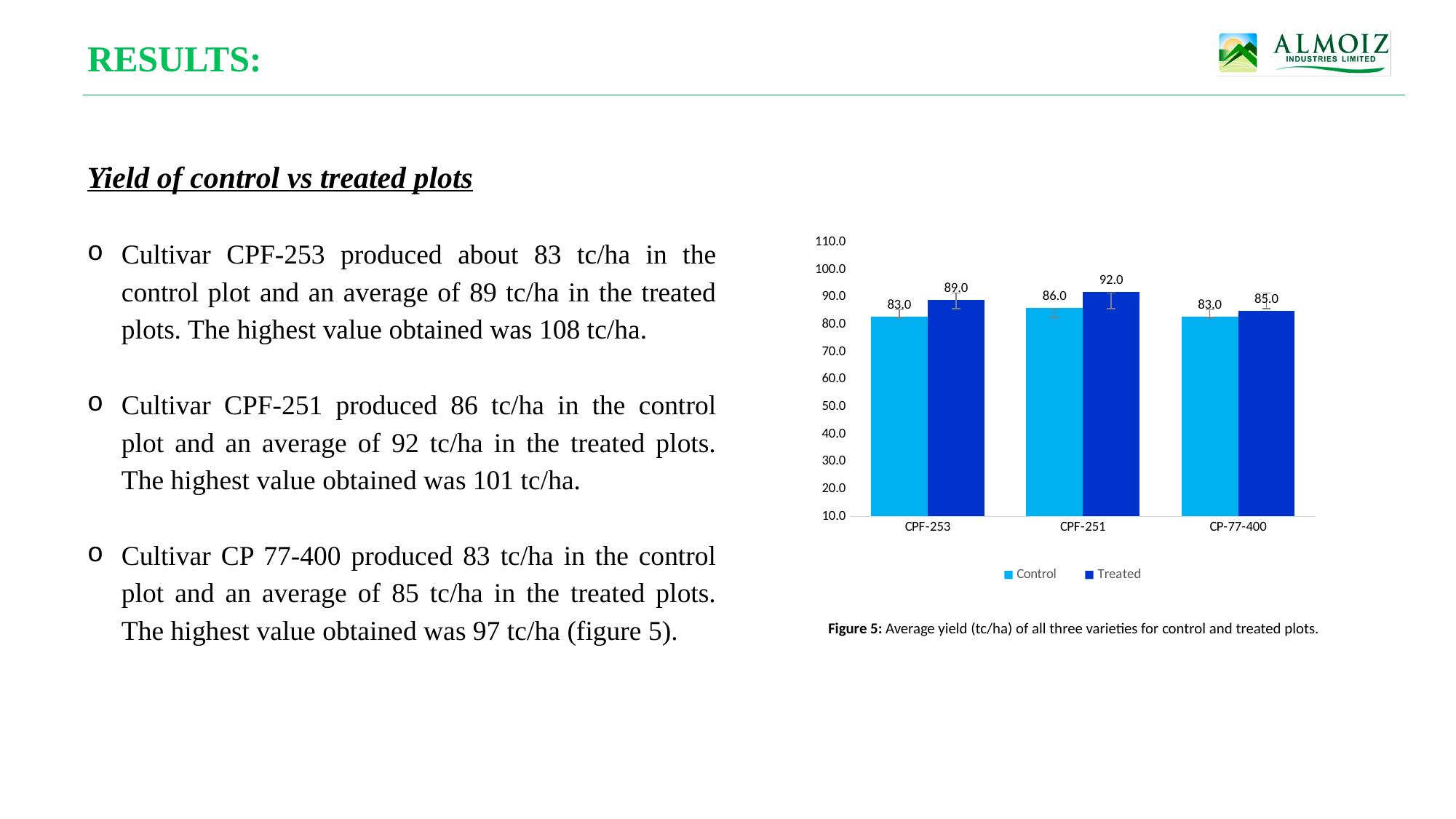
What is the Control value for CPF-251? 86.0 How many series does the legend list? 2 What is the Control value for CPF-253? 83.0 What is the Treated value for CPF-251? 92.0 How many categories are shown on the x axis? 3 What kind of chart is shown on the slide? Bar chart What is the difference between the Treated and Control values for CPF-251? 6.0 Which category has the highest Treated value? CPF-251 What are the two series named in the legend? Control and Treated Which category has the lowest Treated value? CP-77-400 Which is larger for CPF-253: the Control value or the Treated value? Treated What is the Treated value for CP-77-400? 85.0